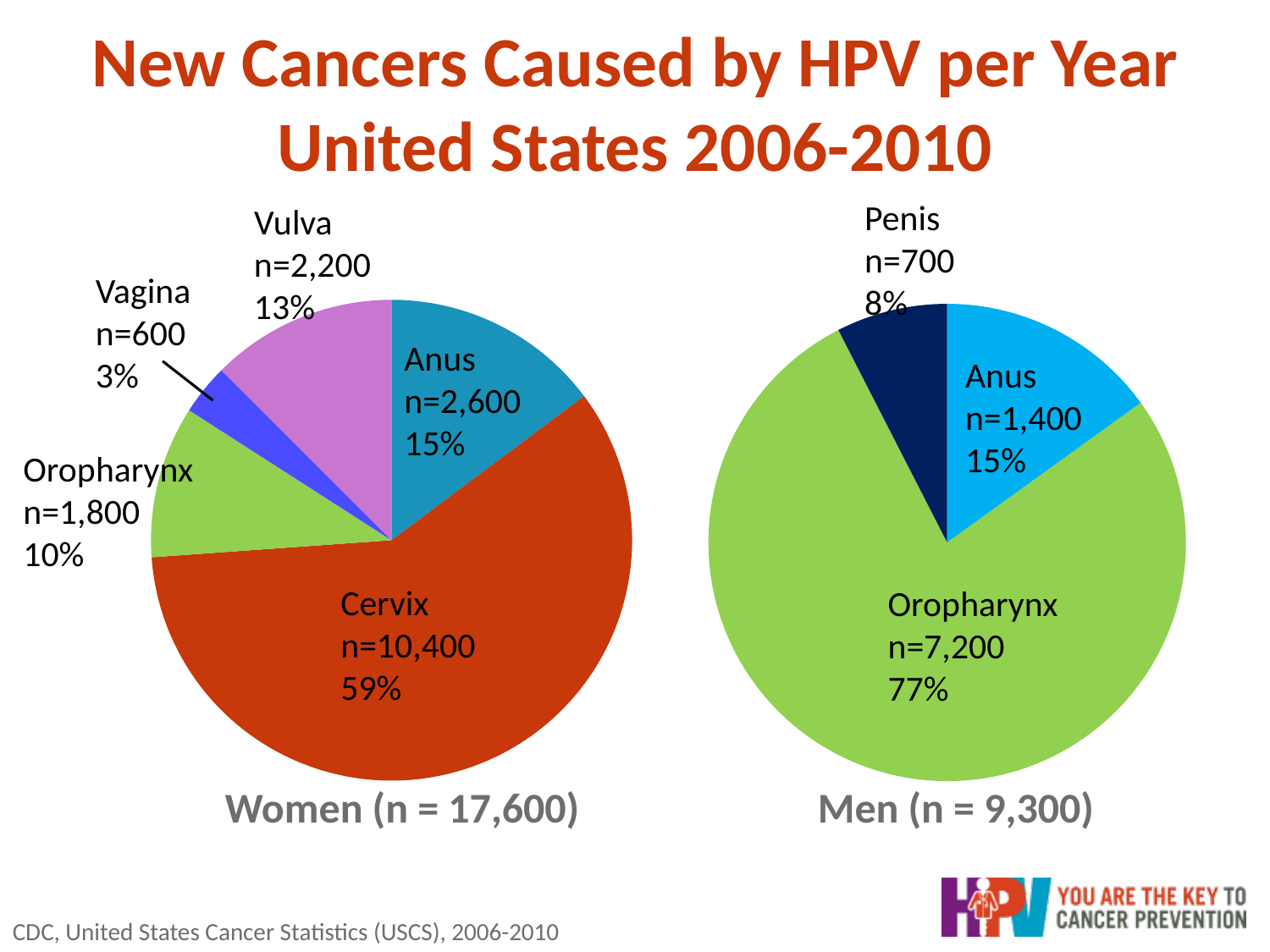
In the Men pie chart, which cancer site has the smallest slice? Penis In the Men pie chart, what share of the pie does Penis represent? 8% In the Men pie chart, what is the difference in number of cases between Oropharynx and Anus? 5,800 Which is larger: the number of Oropharynx cases in the Women chart or in the Men chart? Men What type of chart is used on this slide? Pie chart In the Women pie chart, what is the difference in number of cases between Anus and Vulva? 400 In the Men pie chart, how many new cancers per year are attributed to Oropharynx? n=7,200 In the Women pie chart, which cancer site has the smallest slice? Vagina In the Women pie chart, which cancer site has the largest slice? Cervix In the Women pie chart, how many new cancers per year are attributed to Cervix? n=10,400 How many cancer sites are shown in the Women pie chart? 5 In the Women pie chart, what share of the pie does Vulva represent? 13%